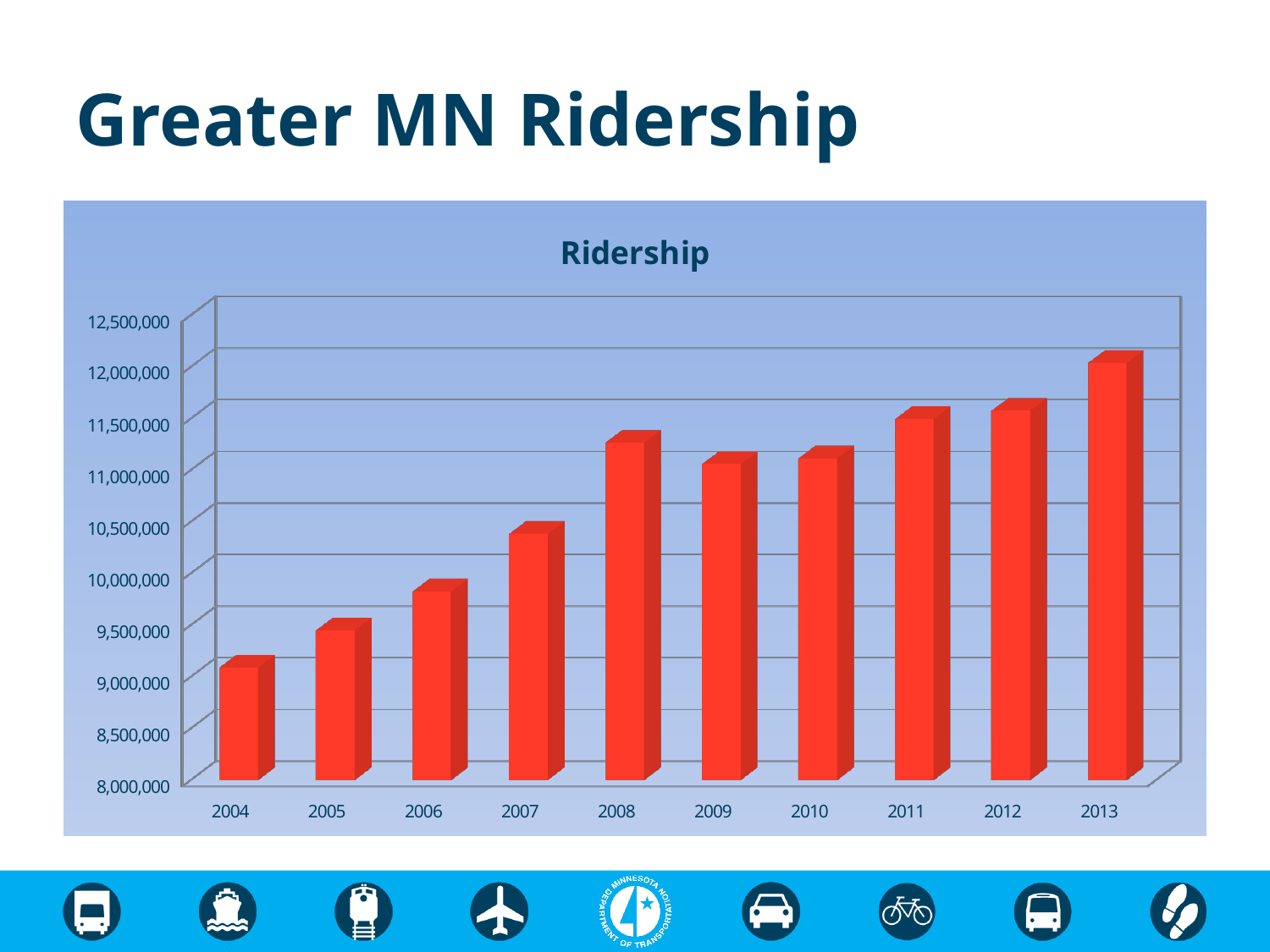
What kind of chart is shown on the slide? bar chart Is the value for 2005 greater or less than 10,000,000? less Which year has the highest ridership? 2013 Is the value for 2008 greater or less than 11,000,000? greater Which year has the larger ridership, 2008 or 2009? 2008 Overall, does ridership rise or fall from 2004 to 2013? rise Which year has the lowest ridership? 2004 Is the value for 2004 greater or less than 9,500,000? less What is the title of the chart? Ridership How many years are shown on the x axis of the chart? 10